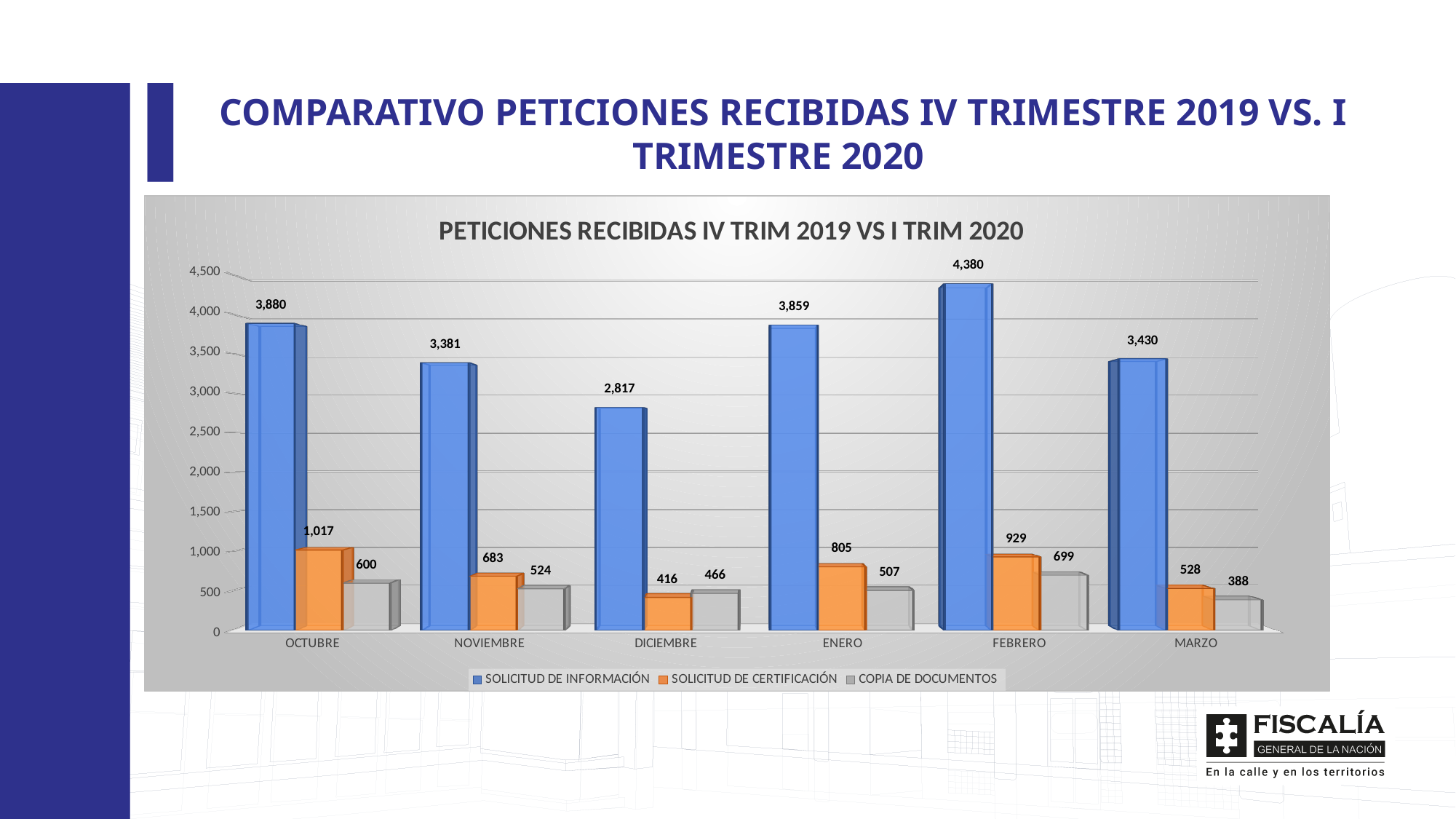
Which is larger: COPIA DE DOCUMENTOS in OCTUBRE or in ENERO? OCTUBRE What kind of chart is shown on the slide? Bar chart What is the title of the chart? PETICIONES RECIBIDAS IV TRIM 2019 VS I TRIM 2020 How many months are shown on the x axis? 6 Is the value of SOLICITUD DE INFORMACIÓN for NOVIEMBRE greater or less than 3,000? greater What is the value of SOLICITUD DE INFORMACIÓN for FEBRERO? 4,380 How many series does the legend list? 3 Which month has the highest value for SOLICITUD DE INFORMACIÓN? FEBRERO What is the difference between SOLICITUD DE INFORMACIÓN in FEBRERO and in DICIEMBRE? 1,563 Which month has the lowest value for SOLICITUD DE CERTIFICACIÓN? DICIEMBRE What is the value of SOLICITUD DE CERTIFICACIÓN for OCTUBRE? 1,017 What is the value of COPIA DE DOCUMENTOS for MARZO? 388